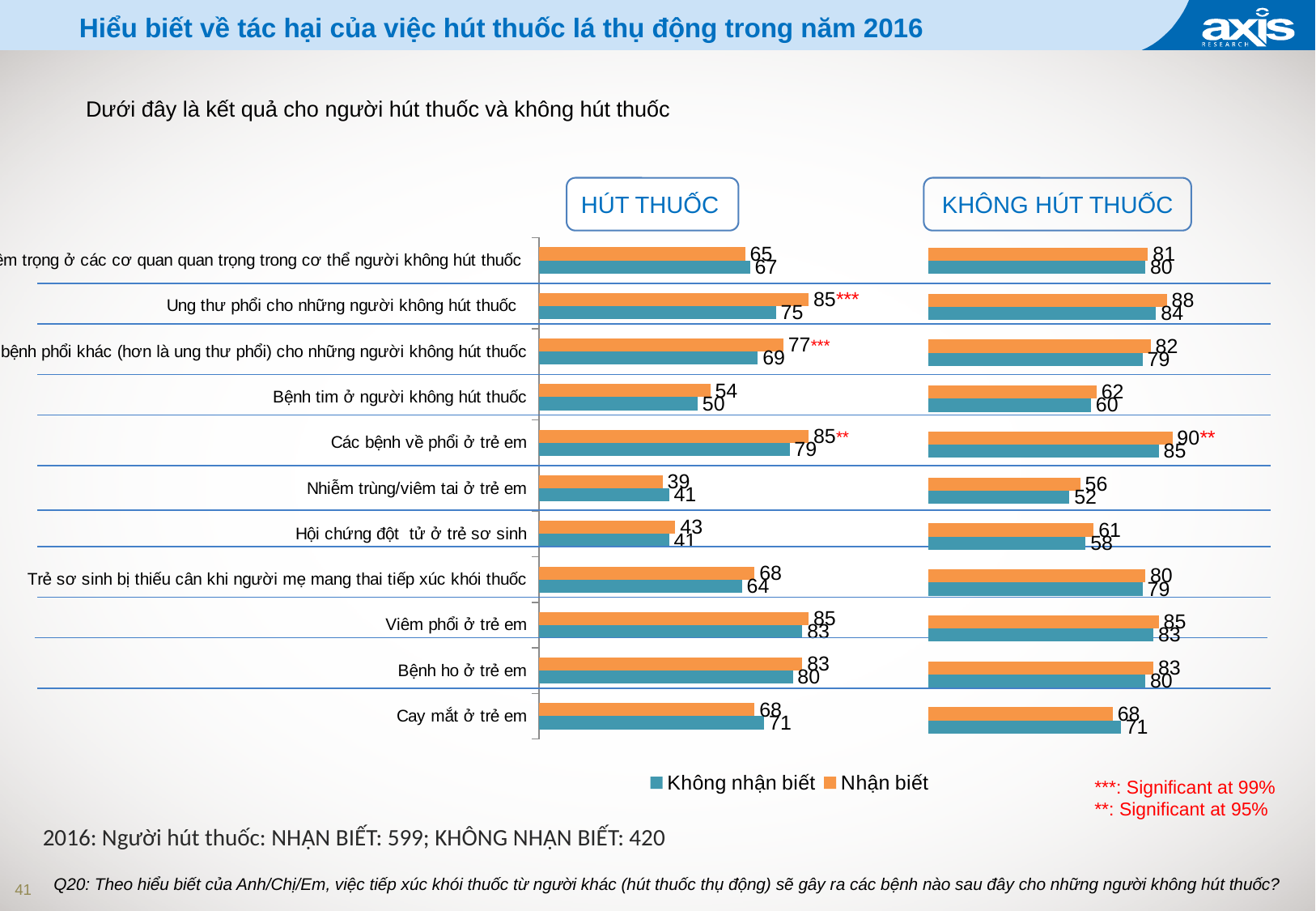
In the HÚT THUỐC chart, which category has the lowest Nhận biết value? Nhiễm trùng/viêm tai ở trẻ em In the HÚT THUỐC chart, which is larger for Cay mắt ở trẻ em: Nhận biết or Không nhận biết? Không nhận biết In the HÚT THUỐC chart, what is the Nhận biết value for Ung thư phổi cho những người không hút thuốc? 85 What kind of chart is the HÚT THUỐC chart? Bar chart In the KHÔNG HÚT THUỐC chart, what is the Không nhận biết value for Bệnh tim ở người không hút thuốc? 60 In the HÚT THUỐC chart, what is the difference between the Nhận biết and Không nhận biết values for Ung thư phổi cho những người không hút thuốc? 10 In the KHÔNG HÚT THUỐC chart, which is larger for Nhiễm trùng/viêm tai ở trẻ em: Nhận biết or Không nhận biết? Nhận biết In the KHÔNG HÚT THUỐC chart, what is the difference between the Nhận biết and Không nhận biết values for Các bệnh về phổi ở trẻ em? 5 In the KHÔNG HÚT THUỐC chart, which category has the highest Nhận biết value? Các bệnh về phổi ở trẻ em Which colour represents the Nhận biết series in the legend? Orange In the KHÔNG HÚT THUỐC chart, what is the Nhận biết value for Các bệnh về phổi ở trẻ em? 90 How many series does the legend list? 2